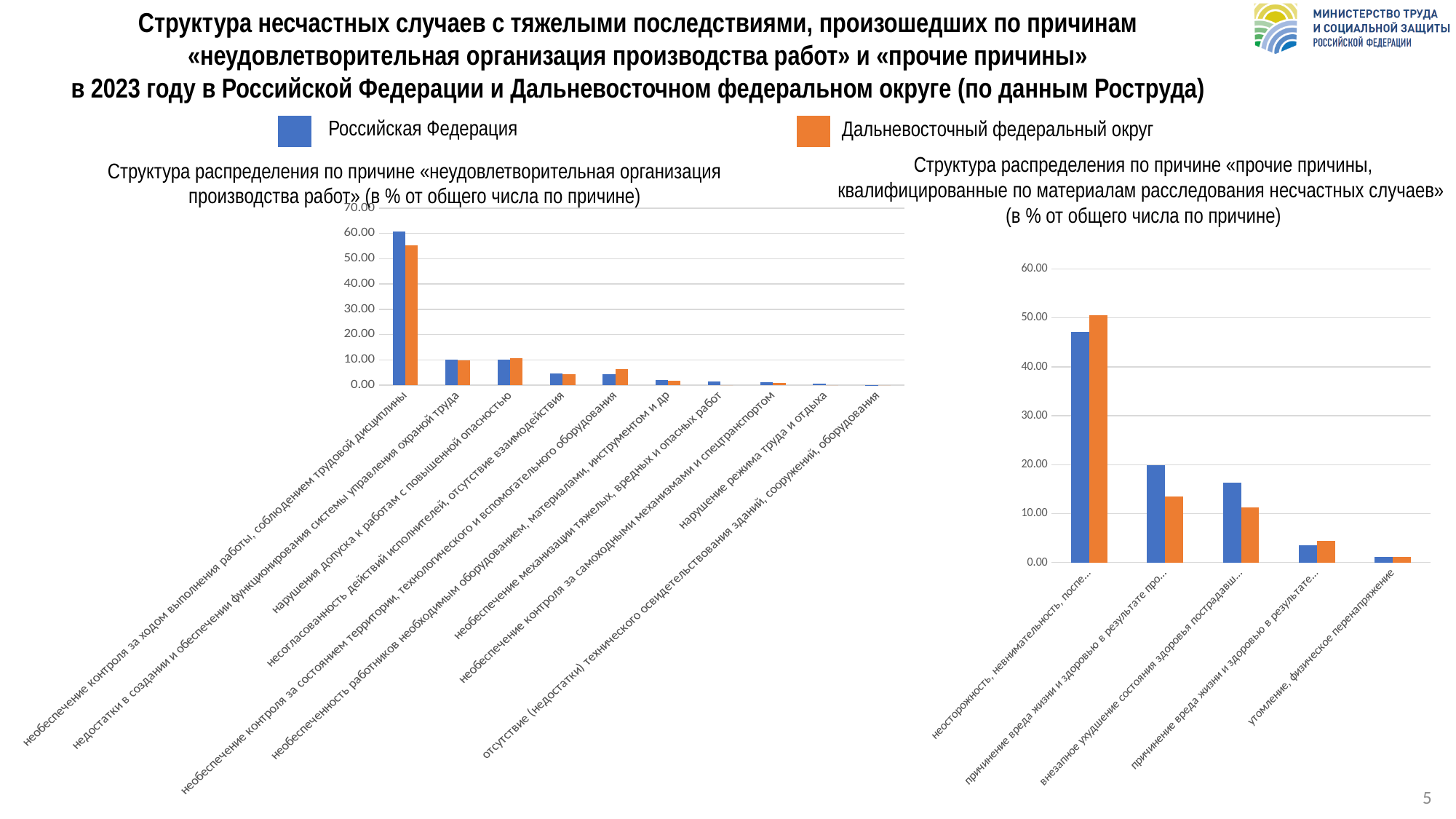
What kind of chart is the left chart («неудовлетворительная организация производства работ»)? bar chart How many categories are shown on the x axis of the left chart («неудовлетворительная организация производства работ»)? 10 How many series does the legend at the top of the slide list? 2 In the left chart («неудовлетворительная организация производства работ»), which category has the highest value for Российская Федерация? необеспечение контроля за ходом выполнения работы, соблюдением трудовой дисциплины In the left chart («неудовлетворительная организация производства работ»), is the Дальневосточный федеральный округ value for «нарушения допуска к работам с повышенной опасностью» greater or less than 20.00? less In the right chart («прочие причины»), is the Дальневосточный федеральный округ value for «неосторожность, невнимательность, после...» greater or less than 40.00? greater Which colour represents Дальневосточный федеральный округ in the charts? orange In the right chart («прочие причины»), for «причинение вреда жизни и здоровью в результате про...», which series has the larger value: Российская Федерация or Дальневосточный федеральный округ? Российская Федерация In the left chart («неудовлетворительная организация производства работ»), is the Российская Федерация value for «необеспечение контроля за ходом выполнения работы, соблюдением трудовой дисциплины» greater or less than 50.00? greater In the left chart («неудовлетворительная организация производства работ»), for «необеспечение контроля за ходом выполнения работы, соблюдением трудовой дисциплины», which series has the larger value: Российская Федерация or Дальневосточный федеральный округ? Российская Федерация In the right chart («прочие причины»), which category has the highest value for Дальневосточный федеральный округ? неосторожность, невнимательность, после... How many categories are shown on the x axis of the right chart («прочие причины»)? 5